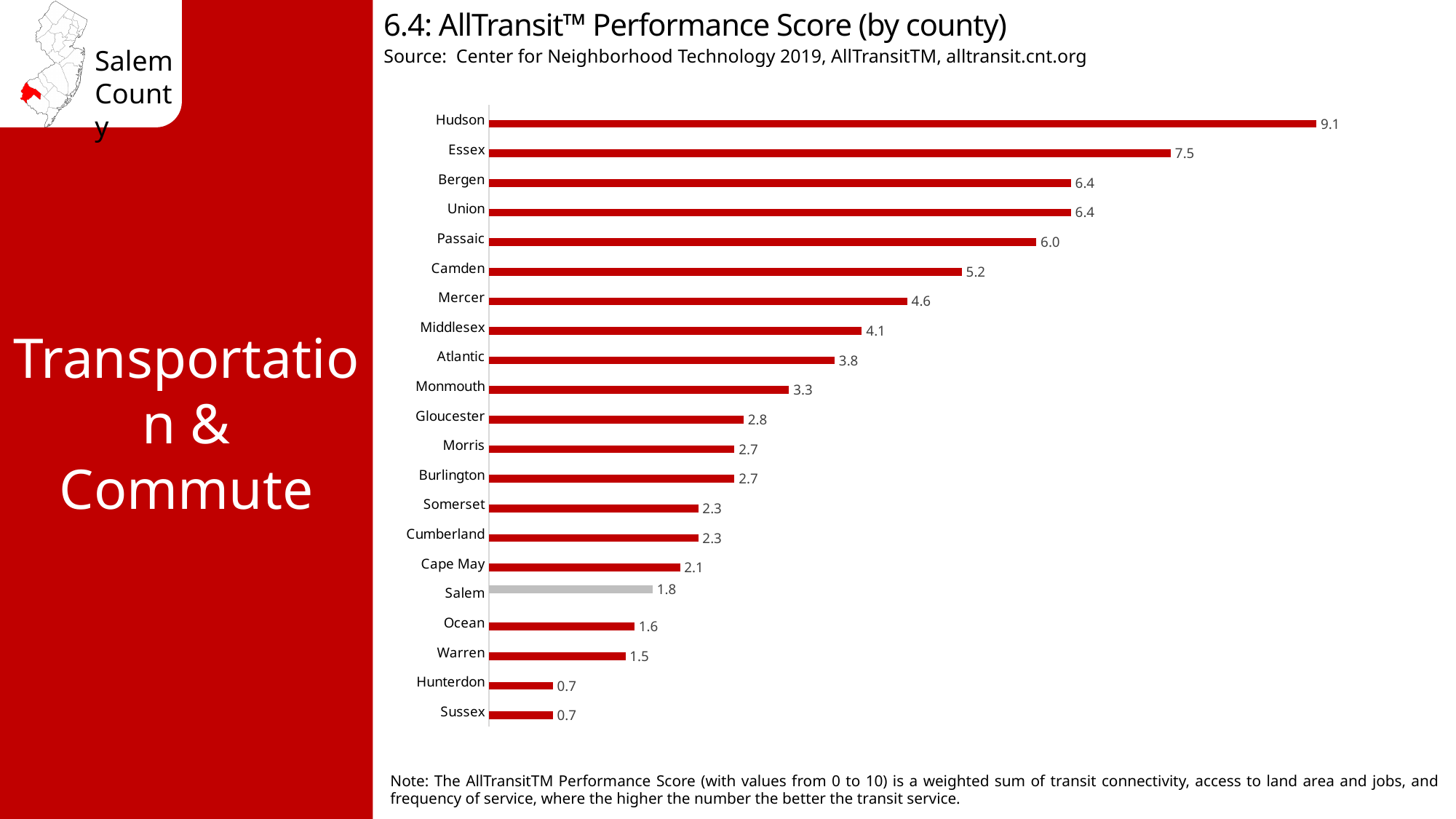
Which county has a higher AllTransit Performance Score, Mercer or Middlesex? Mercer What is the AllTransit Performance Score for Cape May county? 2.1 What is the AllTransit Performance Score for Salem county? 1.8 How many counties are shown in the chart? 21 Which county has the highest AllTransit Performance Score? Hudson Which county has a higher AllTransit Performance Score, Salem or Warren? Salem Which county's bar is shown in gray rather than red? Salem What type of chart is used to show the AllTransit Performance Score by county? Bar chart What is the AllTransit Performance Score for Camden county? 5.2 What is the difference between the AllTransit Performance Scores of Hudson and Essex counties? 1.6 What is the AllTransit Performance Score for Hudson county? 9.1 What is the difference between the AllTransit Performance Scores of Salem and Ocean counties? 0.2